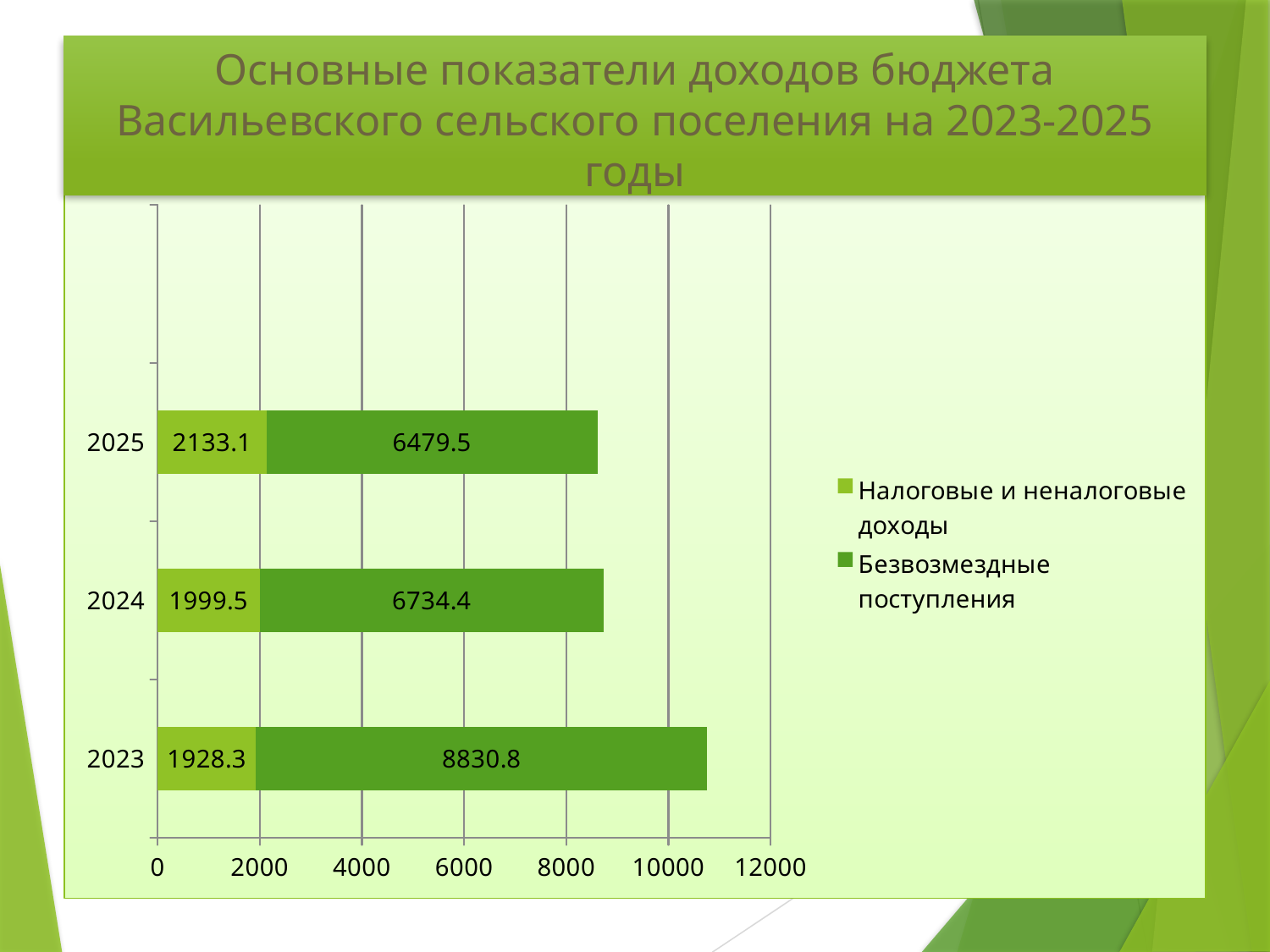
What is the value of Налоговые и неналоговые доходы for 2025? 2133.1 What is the total of the stacked bar for 2023? 10759.1 What is the difference between Безвозмездные поступления in 2023 and in 2025? 2351.3 What is the value of Безвозмездные поступления for 2023? 8830.8 Which year has the lowest value of Налоговые и неналоговые доходы? 2023 Which year has the highest value of Безвозмездные поступления? 2023 What is the value of Безвозмездные поступления for 2024? 6734.4 How many years are shown on the chart? 3 What is the total of the stacked bar for 2025? 8612.6 Which is larger: Налоговые и неналоговые доходы in 2024 or in 2025? 2025 What kind of chart is shown on the slide? Stacked bar chart How many series does the legend list? 2